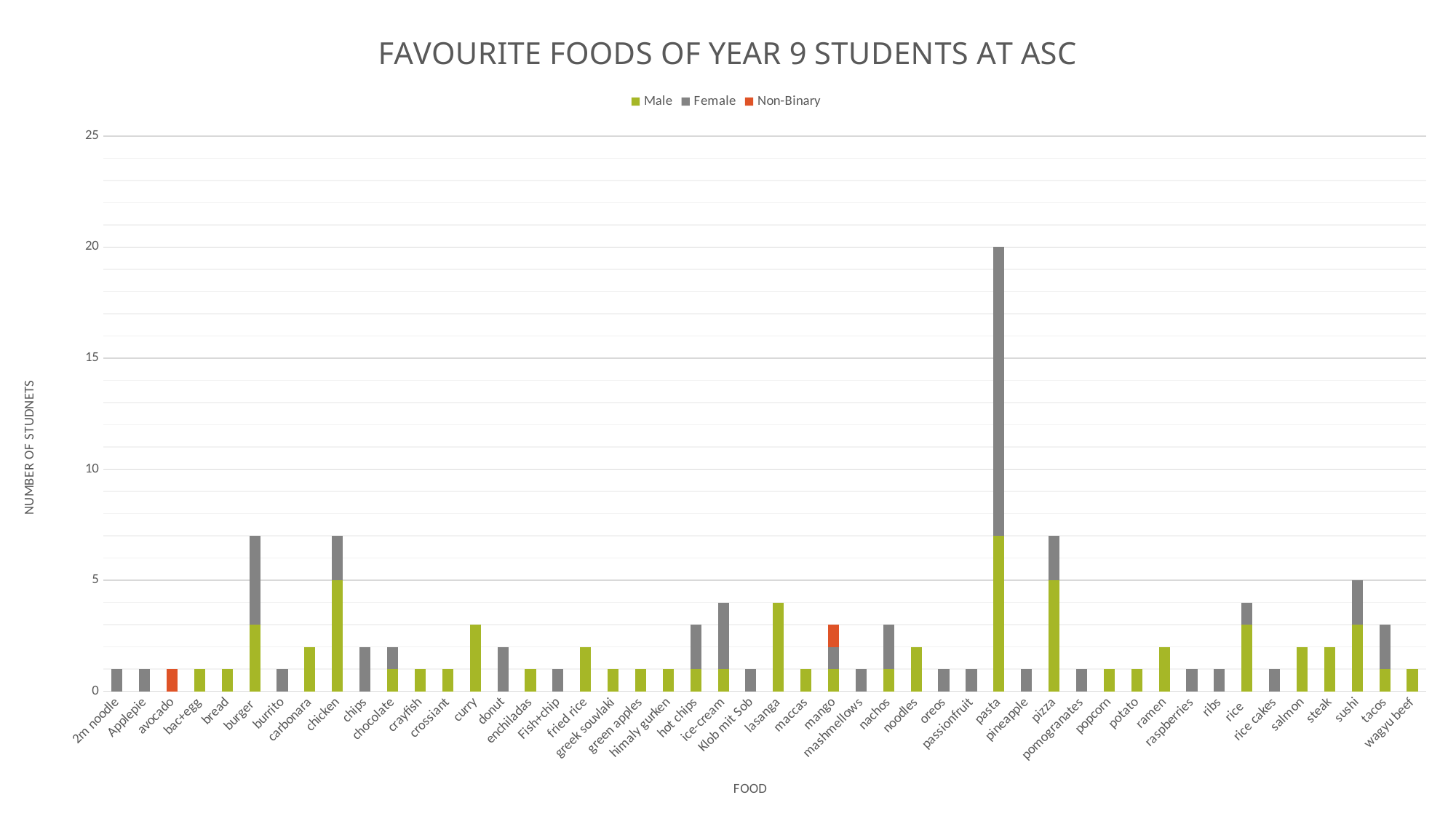
Which food has the highest total number of students? pasta Is the total value for lasanga greater or less than 5? less How many series does the legend list? 3 What is the total number of students for sushi? 5 What is the Male value for chicken? 5 Is the total value for burger greater or less than 5? greater Which has a larger total, pasta or pizza? pasta What kind of chart is shown on the slide? Bar chart What is the title of the chart? FAVOURITE FOODS OF YEAR 9 STUDENTS AT ASC Which has a larger total, burger or curry? burger What is the total number of students for pasta? 20 How many food categories are shown on the x axis? 48